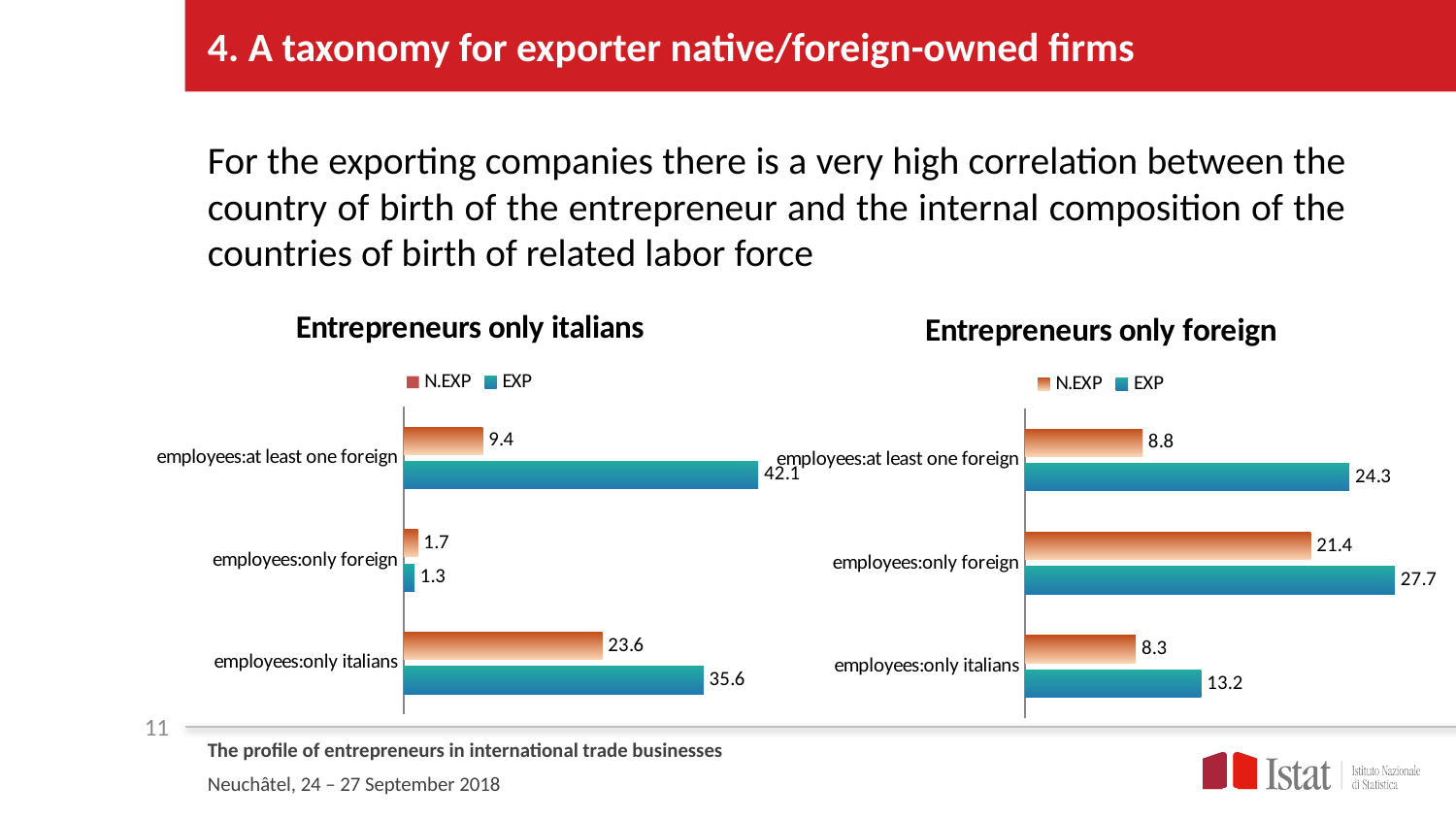
What type of chart is the 'Entrepreneurs only foreign' chart? Bar chart In the 'Entrepreneurs only foreign' chart, what is the N.EXP value for employees:at least one foreign? 8.8 In the 'Entrepreneurs only foreign' chart, which category has the lowest N.EXP value? employees:only italians How many series does the legend of the 'Entrepreneurs only italians' chart list? 2 In the 'Entrepreneurs only italians' chart, which category has the highest EXP value? employees:at least one foreign In the 'Entrepreneurs only italians' chart, which is larger for employees:only foreign, N.EXP or EXP? N.EXP In the 'Entrepreneurs only italians' chart, what is the EXP value for employees:at least one foreign? 42.1 In the 'Entrepreneurs only italians' chart, what is the difference between the EXP and N.EXP values for employees:only italians? 12.0 In the 'Entrepreneurs only foreign' chart, what is the difference between the EXP and N.EXP values for employees:only foreign? 6.3 In the 'Entrepreneurs only foreign' chart, what is the EXP value for employees:only foreign? 27.7 In the 'Entrepreneurs only italians' chart, what is the N.EXP value for employees:only italians? 23.6 How many categories are shown in the 'Entrepreneurs only foreign' chart? 3